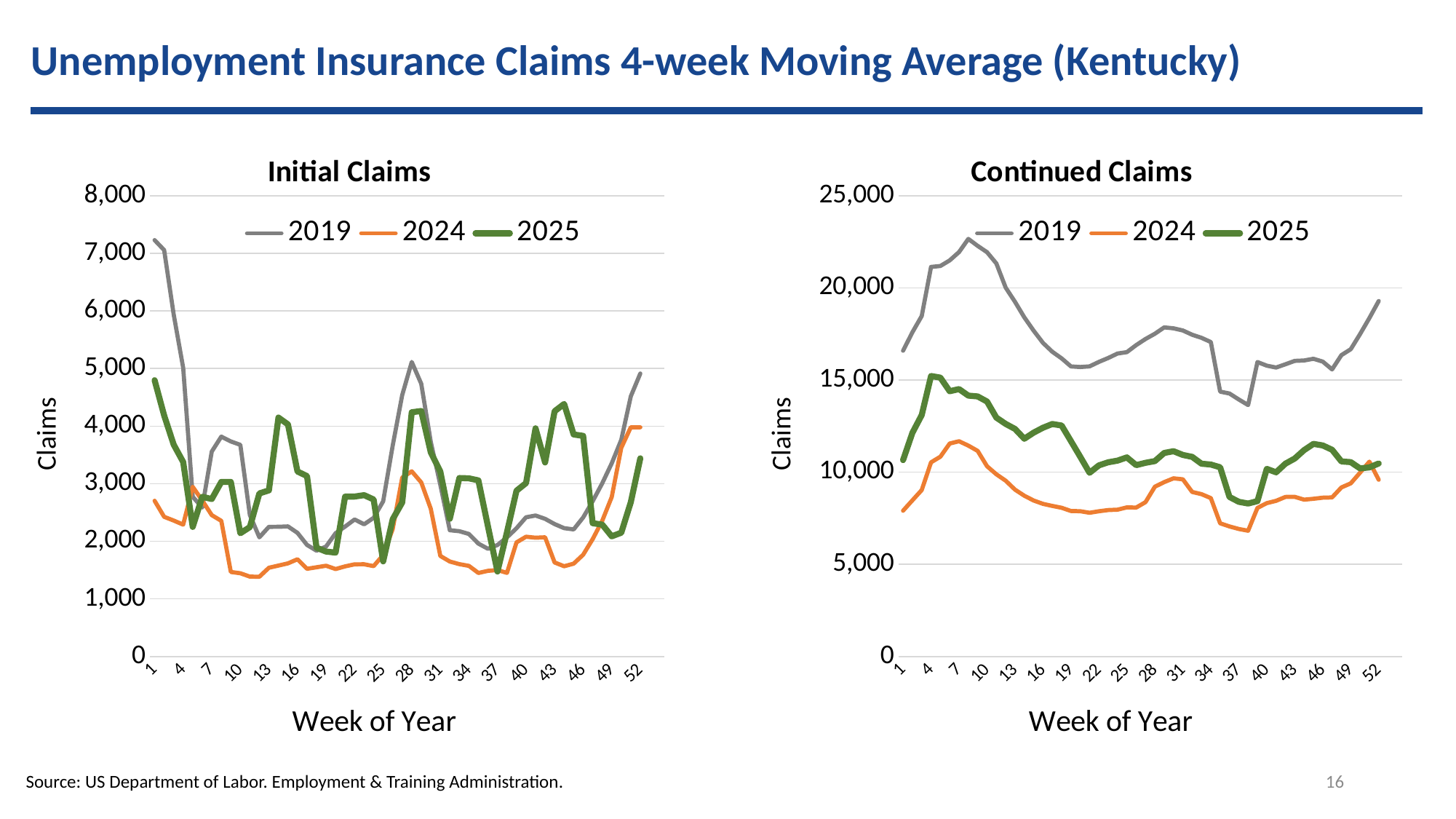
What is the x-axis label on the Continued Claims chart? Week of Year What type of chart is the Initial Claims chart? Line chart In the Initial Claims chart, is the 2024 value at week 10 greater or less than 2,000? less In the Continued Claims chart, does the 2019 line rise or fall from week 1 to week 7? rise In the Continued Claims chart, which series has the highest values across the year? 2019 In the Continued Claims chart, is the 2024 value at week 37 greater or less than 10,000? less In the Initial Claims chart, is the 2025 value at week 1 greater or less than 4,000? greater In the Initial Claims chart, at week 1, which series has the higher value: 2019 or 2025? 2019 How many series does the legend of the Continued Claims chart list? 3